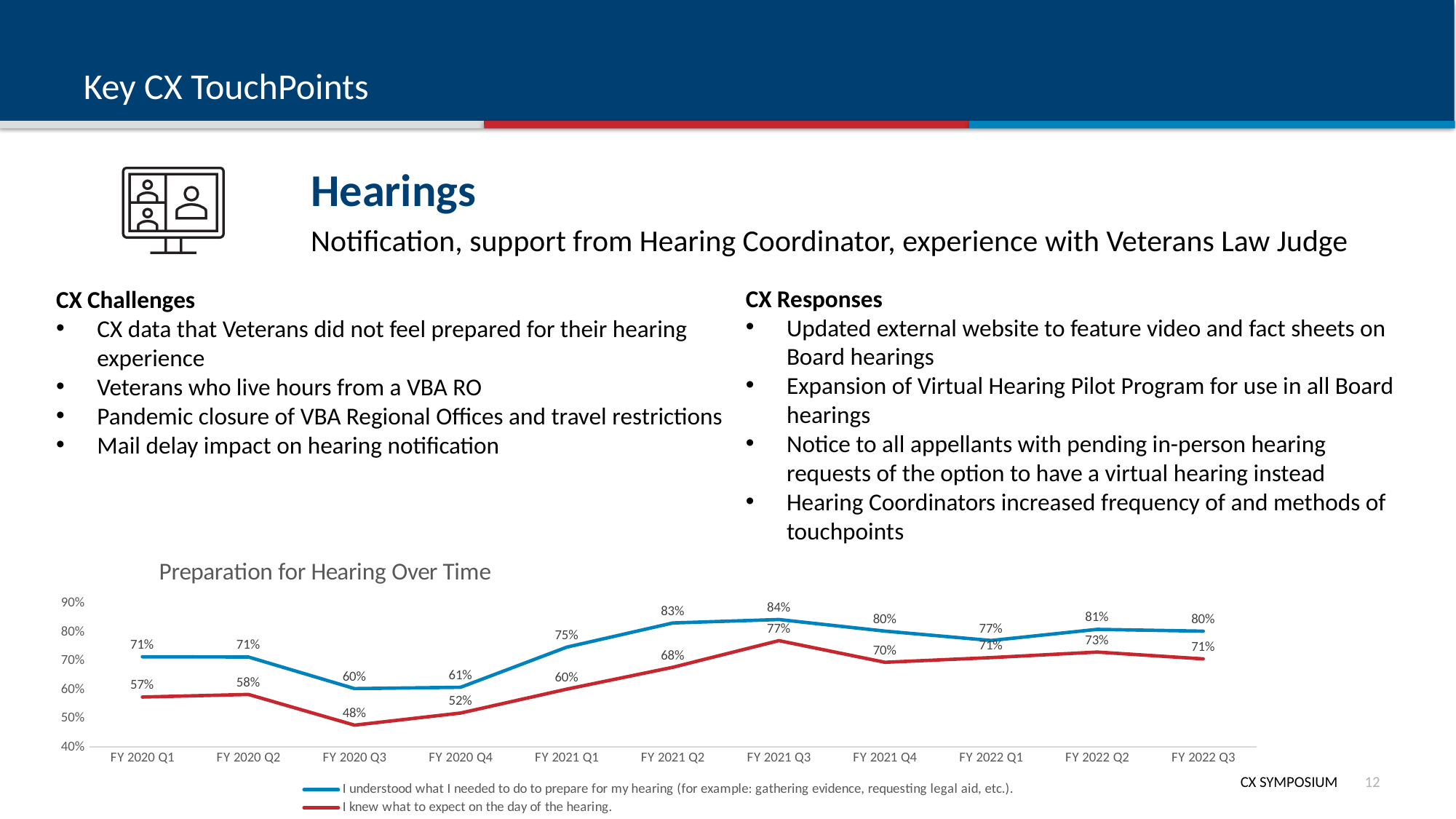
In the "Preparation for Hearing Over Time" chart, in which quarter is "I knew what to expect on the day of the hearing" at its lowest? FY 2020 Q3 What type of chart is "Preparation for Hearing Over Time"? line chart How many series does the legend of the "Preparation for Hearing Over Time" chart list? 2 In the "Preparation for Hearing Over Time" chart, what is the difference between the two series in FY 2020 Q1? 14% In the "Preparation for Hearing Over Time" chart, which series has the higher value in FY 2021 Q3? I understood what I needed to do to prepare for my hearing What colour is the line for "I knew what to expect on the day of the hearing" in the "Preparation for Hearing Over Time" chart? red In the "Preparation for Hearing Over Time" chart, what is the value for "I knew what to expect on the day of the hearing" in FY 2020 Q3? 48% In the "Preparation for Hearing Over Time" chart, does "I knew what to expect on the day of the hearing" rise or fall from FY 2020 Q3 to FY 2021 Q3? rise In the "Preparation for Hearing Over Time" chart, in which quarter does "I understood what I needed to do to prepare for my hearing" reach its highest value? FY 2021 Q3 In the "Preparation for Hearing Over Time" chart, what is the value for "I understood what I needed to do to prepare for my hearing" in FY 2021 Q2? 83% In the "Preparation for Hearing Over Time" chart, is the value for "I knew what to expect on the day of the hearing" in FY 2022 Q2 greater or less than 70%? greater How many quarters are plotted along the x axis of the "Preparation for Hearing Over Time" chart? 11